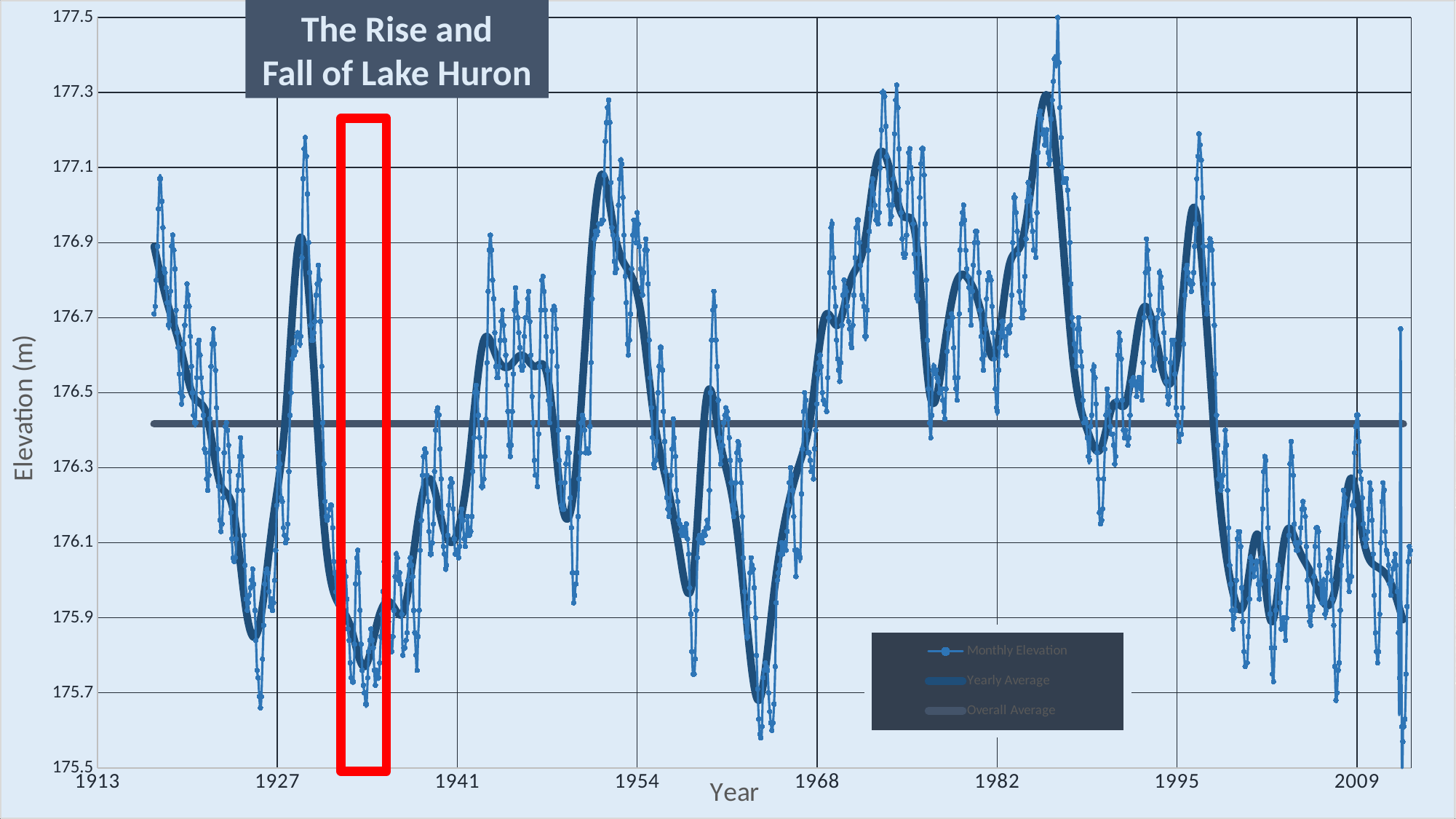
What is the first year labeled on the x axis? 1913 Is the Monthly Elevation peak near 1986 higher or lower than the peak near 1929? higher Does the Yearly Average rise or fall overall between 1995 and 2009? fall Is the Yearly Average at its peak around 1986 greater or less than 177.1? greater What kind of chart is shown on the slide? line chart Is the Overall Average line greater or less than 176.3? greater What is the title of the chart? The Rise and Fall of Lake Huron What is the last year labeled on the x axis? 2009 What is the label of the vertical axis? Elevation (m) How many series does the legend list? 3 Is the Overall Average line greater or less than 176.7? less